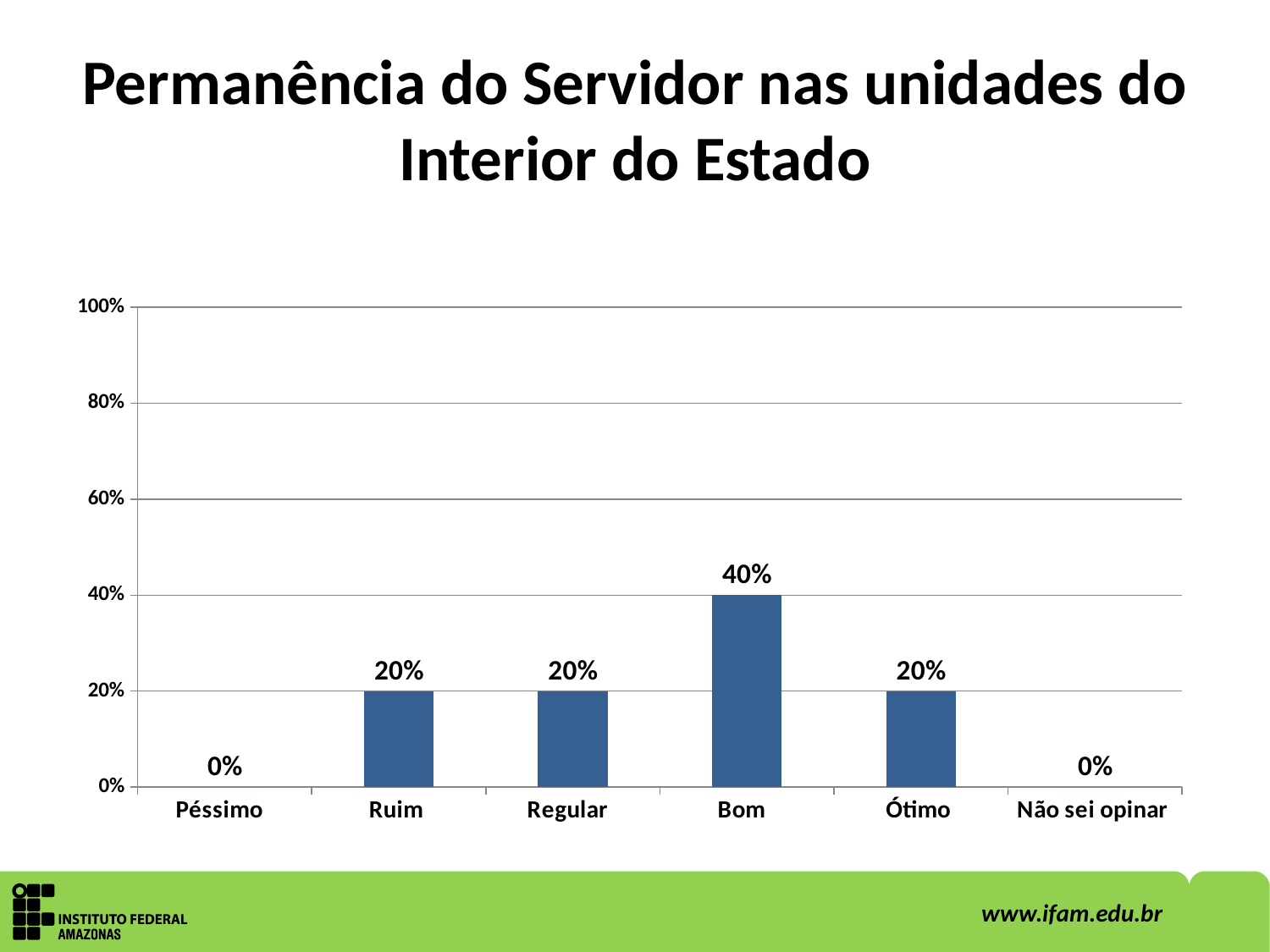
Is the value for Bom greater or less than 60%? less What is the difference between the values for Bom and Ótimo? 20% Which is larger, the value for Bom or the value for Regular? Bom What is the title of the slide? Permanência do Servidor nas unidades do Interior do Estado What kind of chart is shown on the slide? bar chart What is the value for Ruim? 20% What is the value for Não sei opinar? 0% What is the value for Bom? 40% How many categories have a value of 20%? 3 What is the value for Péssimo? 0% Which category has the highest value? Bom How many categories are shown on the x axis? 6